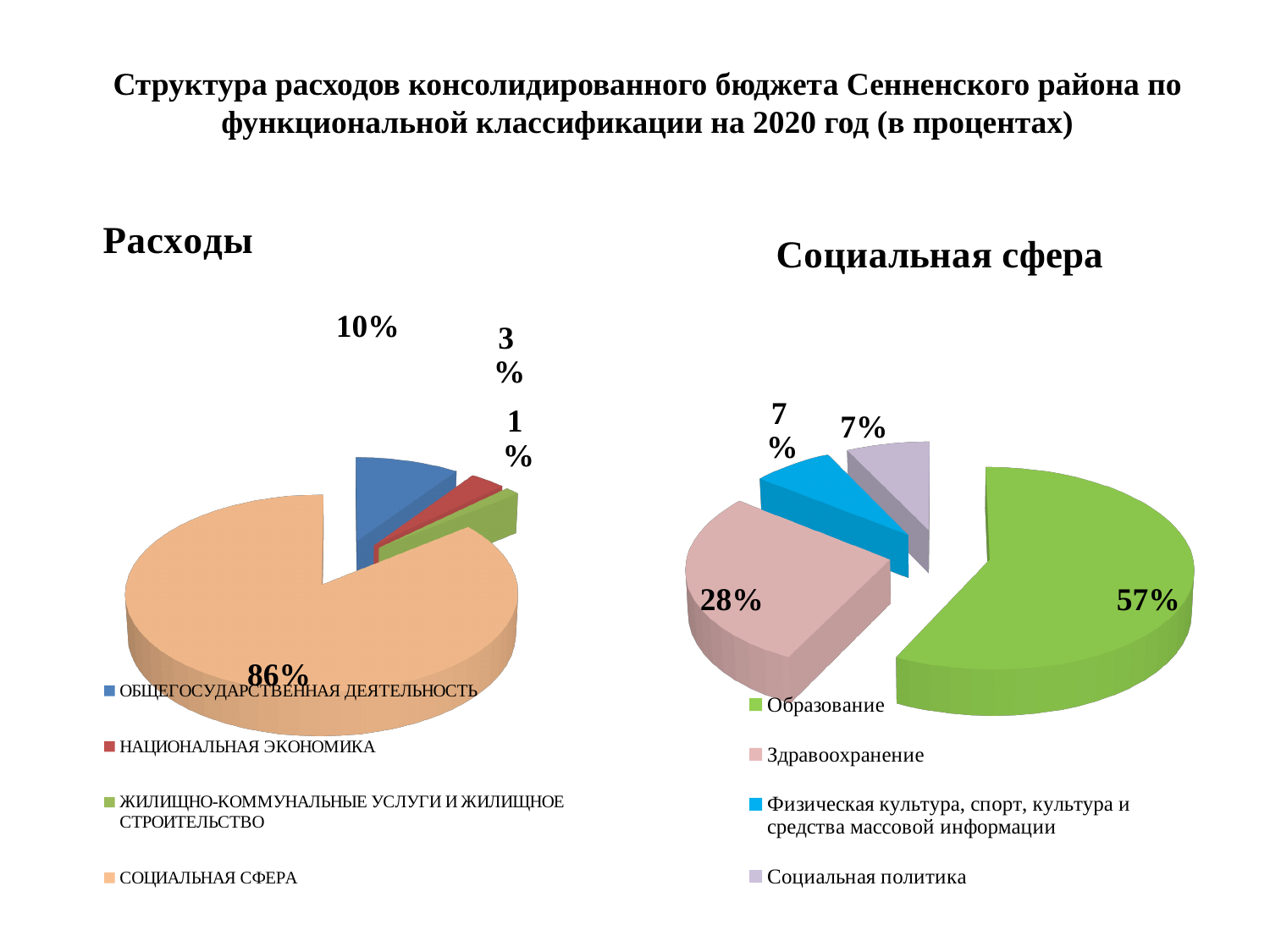
In the "Расходы" chart, what share is shown for ОБЩЕГОСУДАРСТВЕННАЯ ДЕЯТЕЛЬНОСТЬ? 10% In the "Социальная сфера" chart, what share is shown for Здравоохранение? 28% In the "Социальная сфера" chart, which is larger: Образование or Здравоохранение? Образование In the "Социальная сфера" chart, what is the difference between the shares of Образование and Здравоохранение? 29% In the "Расходы" chart, what share is shown for СОЦИАЛЬНАЯ СФЕРА? 86% What kind of chart is the "Социальная сфера" chart? Pie chart In the "Расходы" chart, which category has the largest share? СОЦИАЛЬНАЯ СФЕРА In the "Социальная сфера" chart, what share is shown for Образование? 57% How many categories does the legend of the "Расходы" chart list? 4 In the "Социальная сфера" chart, what colour is the Образование slice? Green In the "Расходы" chart, what is the difference between the shares of ОБЩЕГОСУДАРСТВЕННАЯ ДЕЯТЕЛЬНОСТЬ and НАЦИОНАЛЬНАЯ ЭКОНОМИКА? 7% In the "Расходы" chart, which category has the smallest share? ЖИЛИЩНО-КОММУНАЛЬНЫЕ УСЛУГИ И ЖИЛИЩНОЕ СТРОИТЕЛЬСТВО